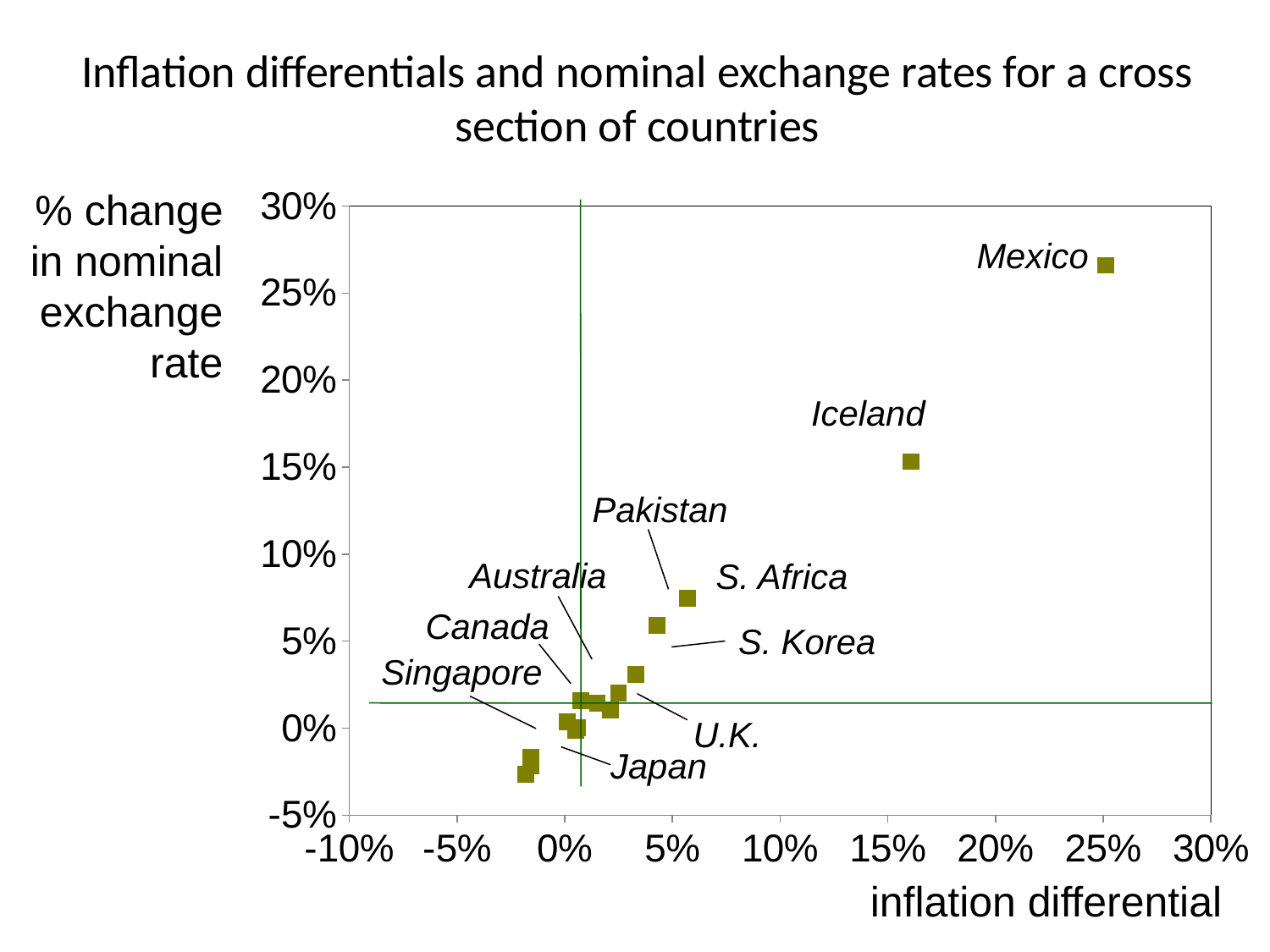
Is the % change in nominal exchange rate for Iceland greater or less than 20%? less What kind of chart is shown on the slide? scatter chart Is the % change in nominal exchange rate for Mexico greater or less than 25%? greater Which country has the highest % change in nominal exchange rate? Mexico Is the inflation differential for Iceland greater or less than 10%? greater Do the % changes in nominal exchange rate generally rise or fall as the inflation differential increases? rise Which country has the highest inflation differential? Mexico What is the label of the horizontal axis? inflation differential Which has the larger % change in nominal exchange rate, Iceland or Pakistan? Iceland